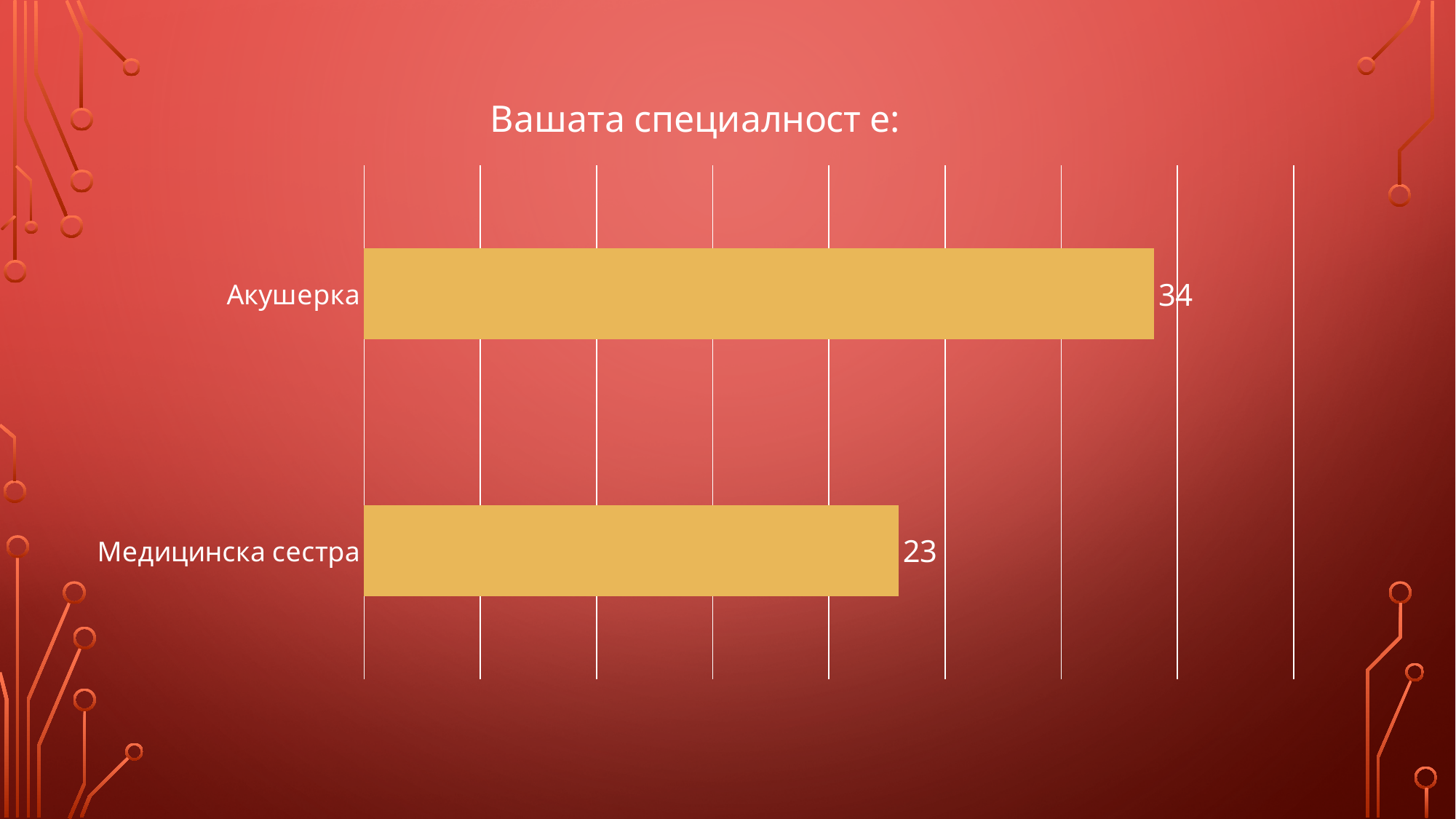
What is the difference between the values for Акушерка and Медицинска сестра? 11 Which is larger, the value for Акушерка or the value for Медицинска сестра? Акушерка Which category has the highest value? Акушерка What colour are the bars in the chart? yellow/gold What is the value for Акушерка? 34 What is the total of the two values shown in the chart? 57 Which category has the lowest value? Медицинска сестра What is the value for Медицинска сестра? 23 What is the title of the chart? Вашата специалност е: What kind of chart is shown on the slide? bar chart How many categories are shown in the chart? 2